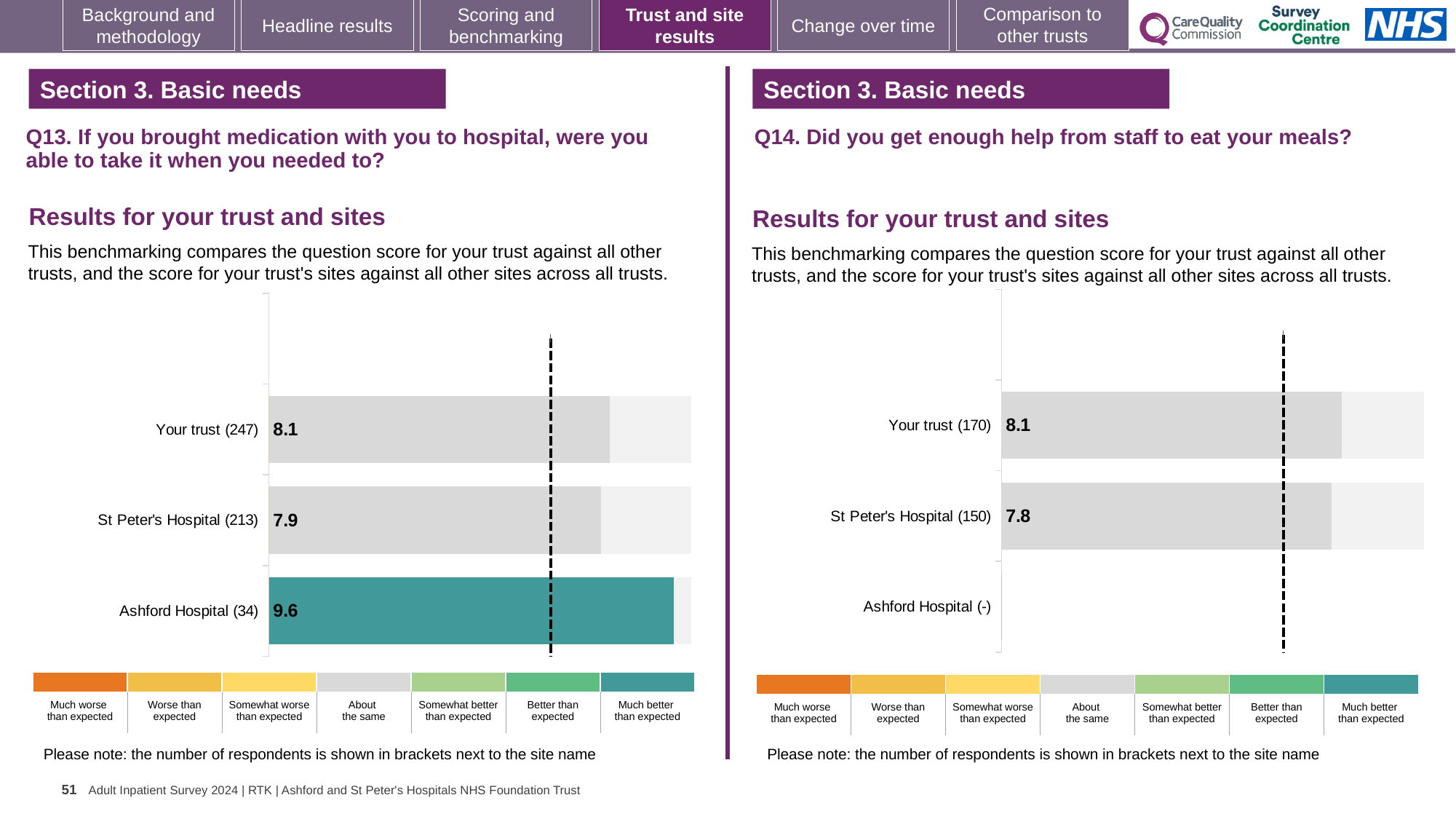
What type of chart is used for the Q14 results on the right? Bar chart In the Q13 chart on the left, which site or trust has the lowest score? St Peter's Hospital In the Q13 chart on the left, what is the score for St Peter's Hospital? 7.9 In the Q13 chart on the left, which has the larger score, Your trust or St Peter's Hospital? Your trust In the Q14 chart on the right, what is the score for Your trust? 8.1 How many bars are plotted in the Q13 chart on the left? 3 In the Q13 chart on the left, what is the score for Your trust? 8.1 In the Q13 chart on the left, what is the difference between the scores for Ashford Hospital and St Peter's Hospital? 1.7 In the Q14 chart on the right, what is the score for St Peter's Hospital? 7.8 In the Q14 chart on the right, what is the difference between the scores for Your trust and St Peter's Hospital? 0.3 In the Q13 chart on the left, which site or trust has the highest score? Ashford Hospital In the Q13 chart on the left, what is the score for Ashford Hospital? 9.6